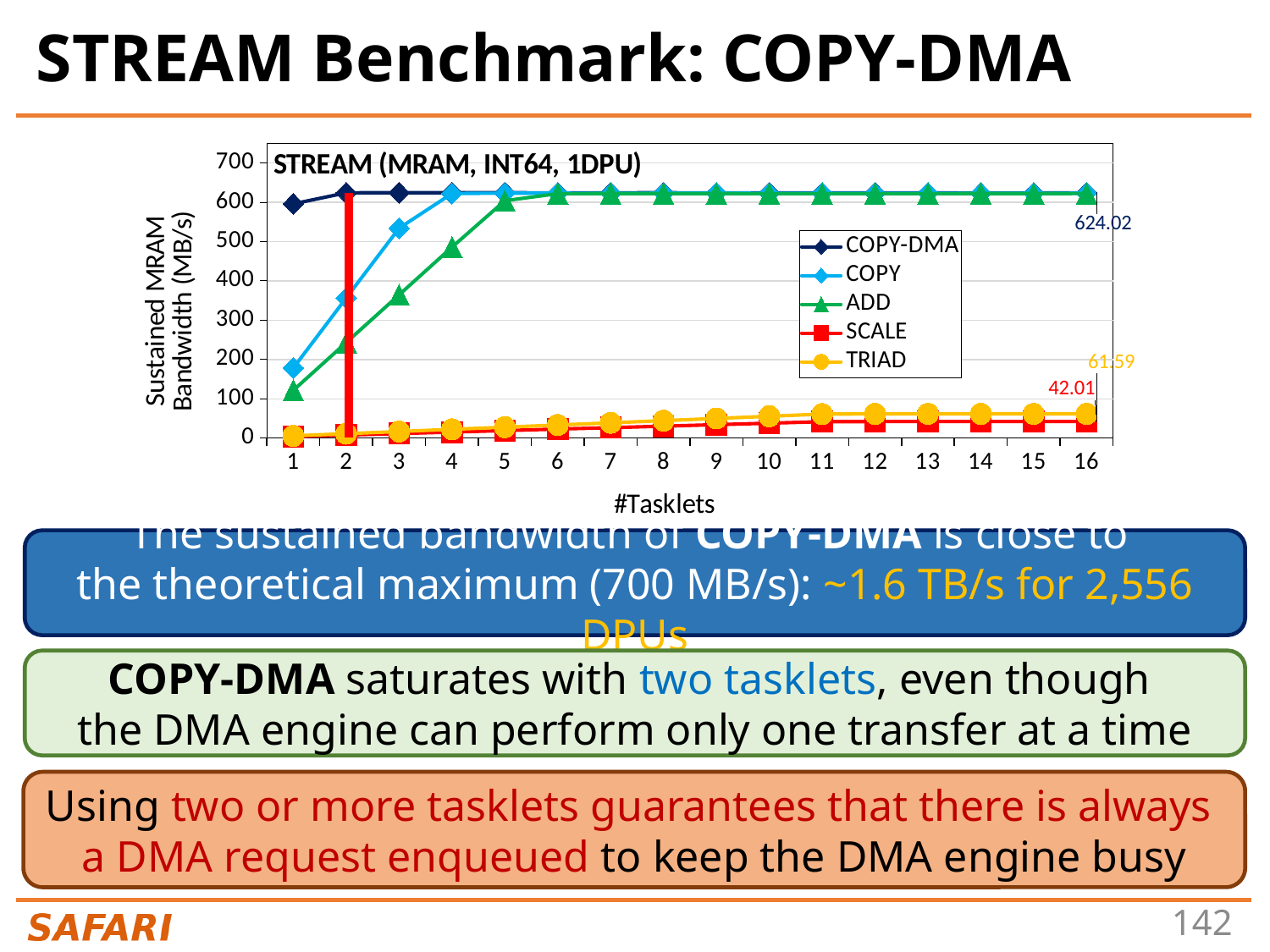
What is the difference between the labeled COPY-DMA value (624.02) and the labeled SCALE value (42.01) at 16 tasklets? 582.01 Which series has the lowest value at 16 tasklets? SCALE What is the labeled value of TRIAD at 16 tasklets? 61.59 Is the value for ADD at 2 tasklets greater or less than 300? less What is the labeled value of COPY-DMA at 16 tasklets? 624.02 How many tasklet counts are shown on the x axis? 16 Which series has the highest value at 1 tasklet? COPY-DMA What is the labeled value of SCALE at 16 tasklets? 42.01 At 16 tasklets, which series has the larger labeled value, TRIAD or SCALE? TRIAD What kind of chart is shown on the slide? Line chart Is the value for COPY-DMA at 1 tasklet greater or less than 500? greater How many series does the legend list? 5